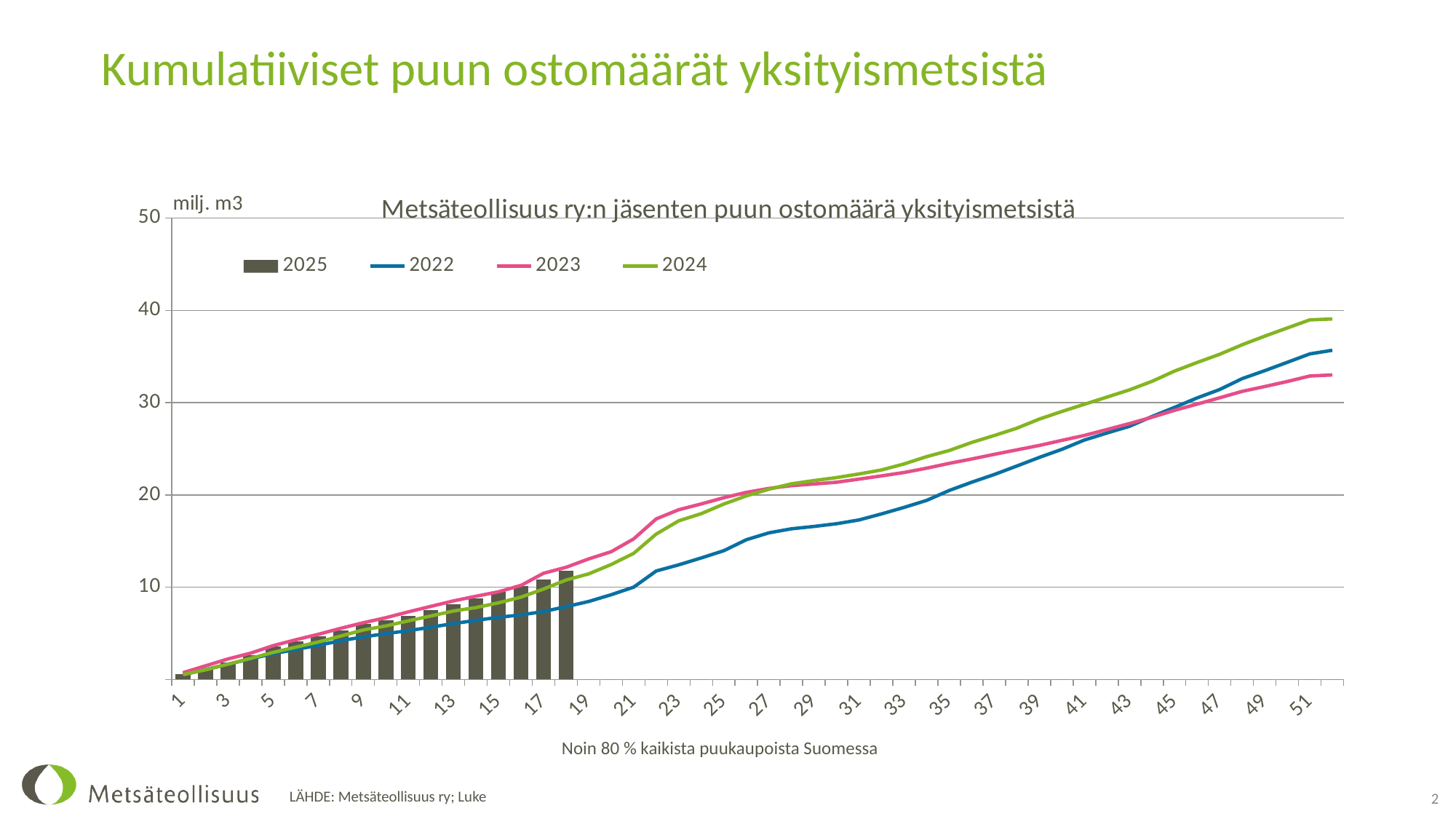
Is the value for 2023 at week 23 greater or less than 20? less Which series is drawn as bars rather than a line? 2025 Is the 2025 bar at week 9 greater or less than 10? less Is the value for 2022 at week 27 greater or less than 20? less What kind of chart is shown on the slide? Combined bar and line chart What is the title of the chart? Metsäteollisuus ry:n jäsenten puun ostomäärä yksityismetsistä Which series has the lowest value at week 51? 2023 Which series has the highest value at week 51? 2024 At week 27, which is larger, the value for 2023 or the value for 2022? 2023 How many series does the chart legend list? 4